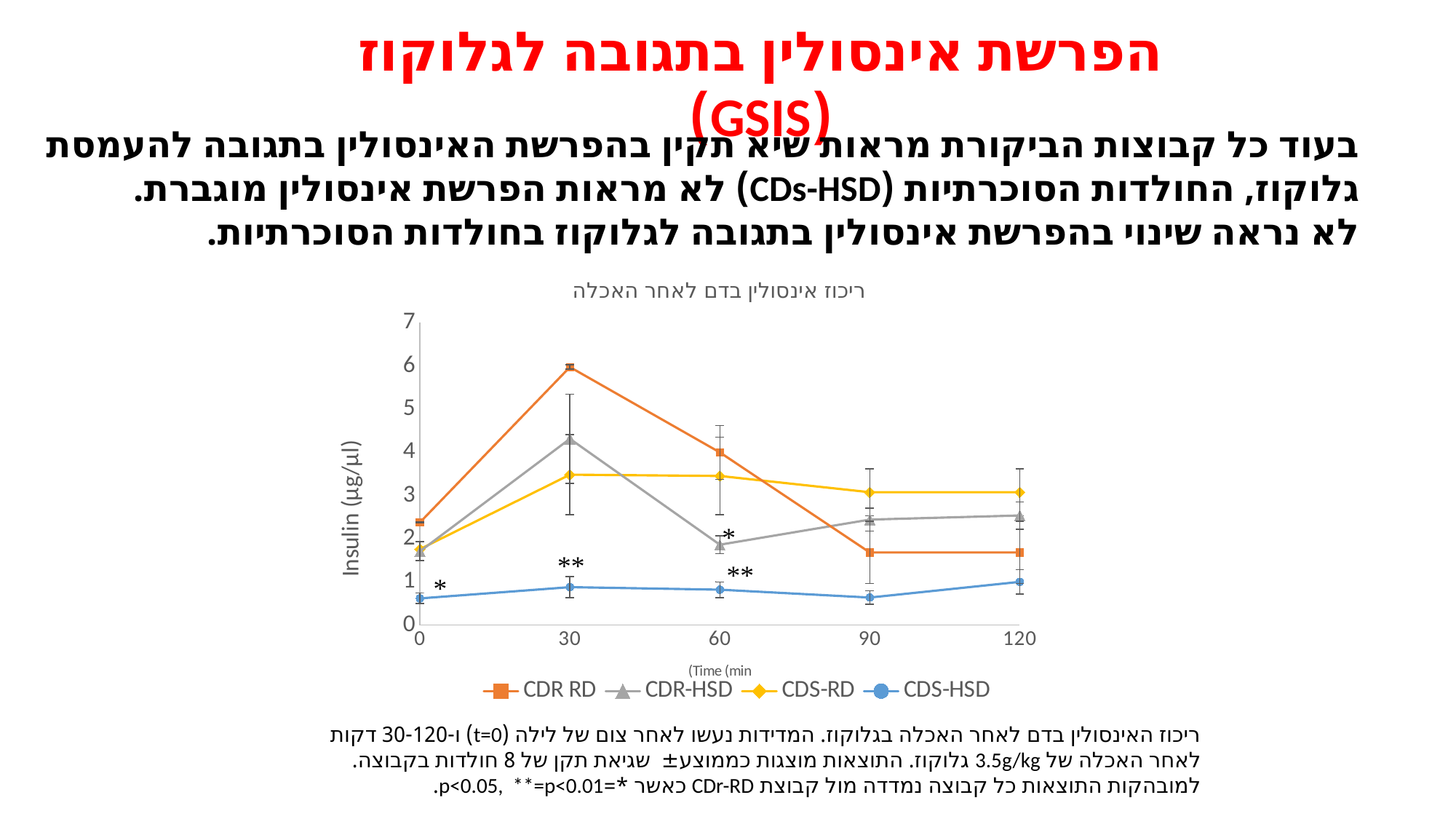
At 120 min, which is larger: CDS-RD or CDR RD? CDS-RD Is the value for CDS-RD at 60 min greater or less than 3? greater Is the value for CDR RD at 30 min greater or less than 5? greater Is the value for CDS-HSD at 0 min greater or less than 1? less What is the label of the y axis? Insulin (µg/µl) How many time points are plotted along the x axis? 5 Does the CDR RD series rise or fall between 30 min and 90 min? fall Which series has the lowest insulin value at 30 min? CDS-HSD Which series has the highest insulin value at 30 min? CDR RD What kind of chart is shown on the slide? line chart At 90 min, which is larger: CDR-HSD or CDR RD? CDR-HSD How many series does the legend list? 4